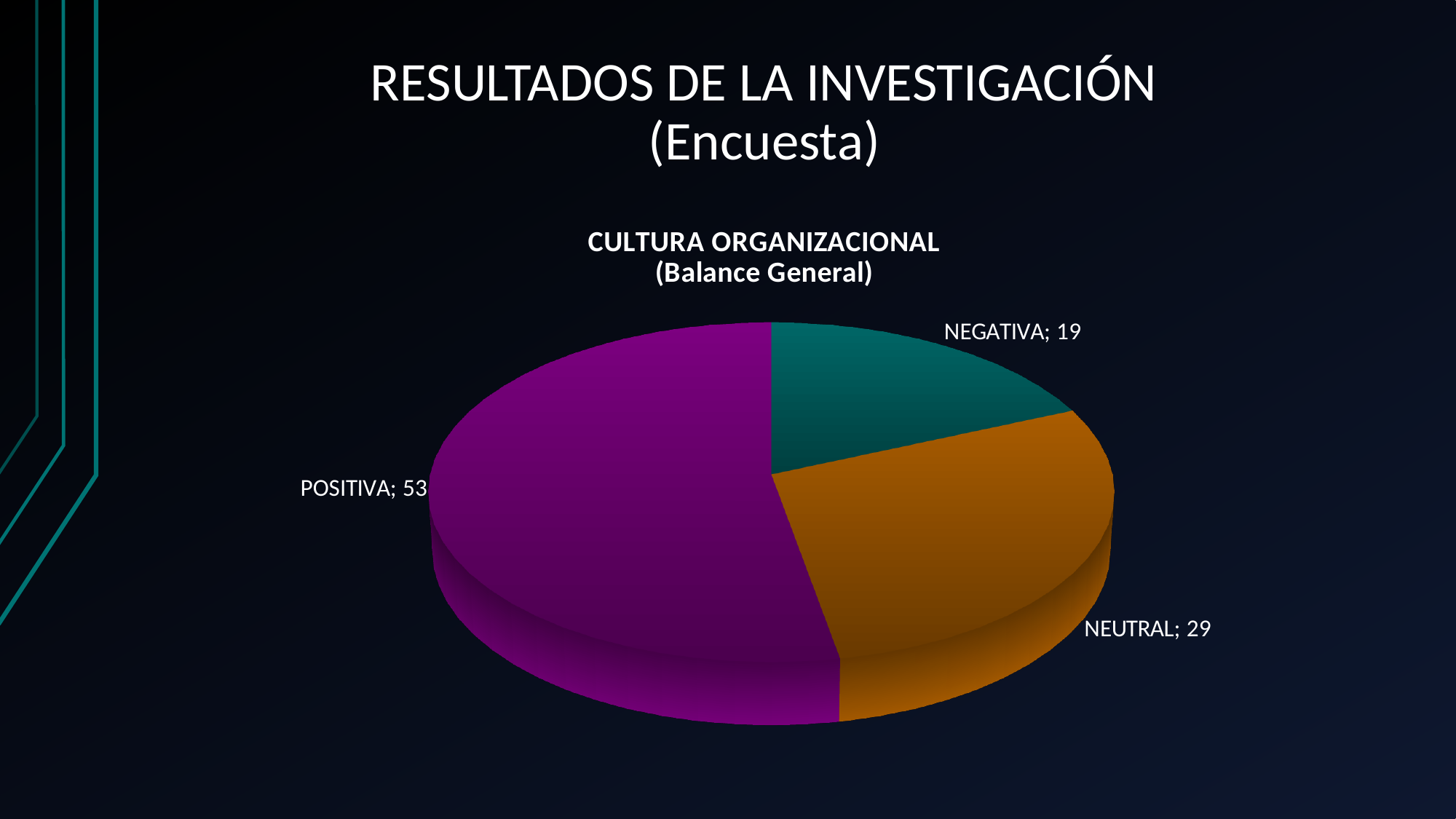
What is the value for NEUTRAL? 29 How many categories are shown in the pie chart? 3 What is the difference between the POSITIVA and NEUTRAL values? 24 Which category has the smallest slice? NEGATIVA Which is larger, NEUTRAL or NEGATIVA? NEUTRAL What kind of chart is shown on the slide? Pie chart Which category has the largest slice? POSITIVA What is the difference between the NEUTRAL and NEGATIVA values? 10 What is the value for POSITIVA? 53 What is the total of all the slices in the pie chart? 101 What is the title of the chart? CULTURA ORGANIZACIONAL (Balance General) What is the value for NEGATIVA? 19